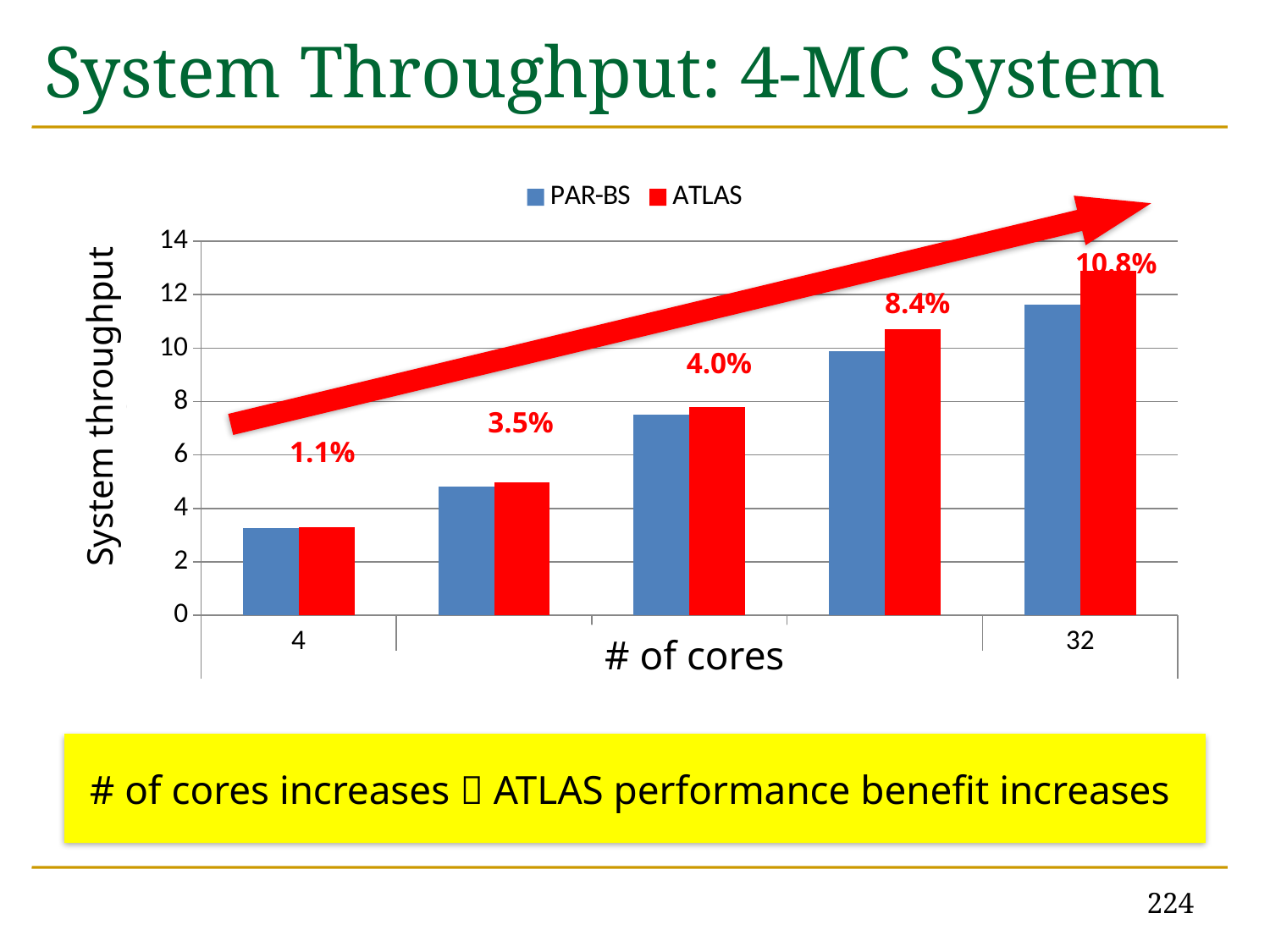
How many series does the legend list? 2 What percentage improvement label is printed above the bars for 32 cores? 10.8% Which core count has the lowest system throughput? 4 At 32 cores, which series has the larger system throughput, PAR-BS or ATLAS? ATLAS Which core count has the highest system throughput? 32 What kind of chart is shown on the slide? bar chart Which two series are listed in the legend? PAR-BS and ATLAS Is the PAR-BS system throughput at 4 cores greater or less than 4? less How many groups of bars (core counts) are plotted on the chart? 5 What is the title of the y axis? System throughput Do the system throughput values rise or fall as the number of cores increases along the x axis? rise Is the ATLAS system throughput at 32 cores greater or less than 12? greater